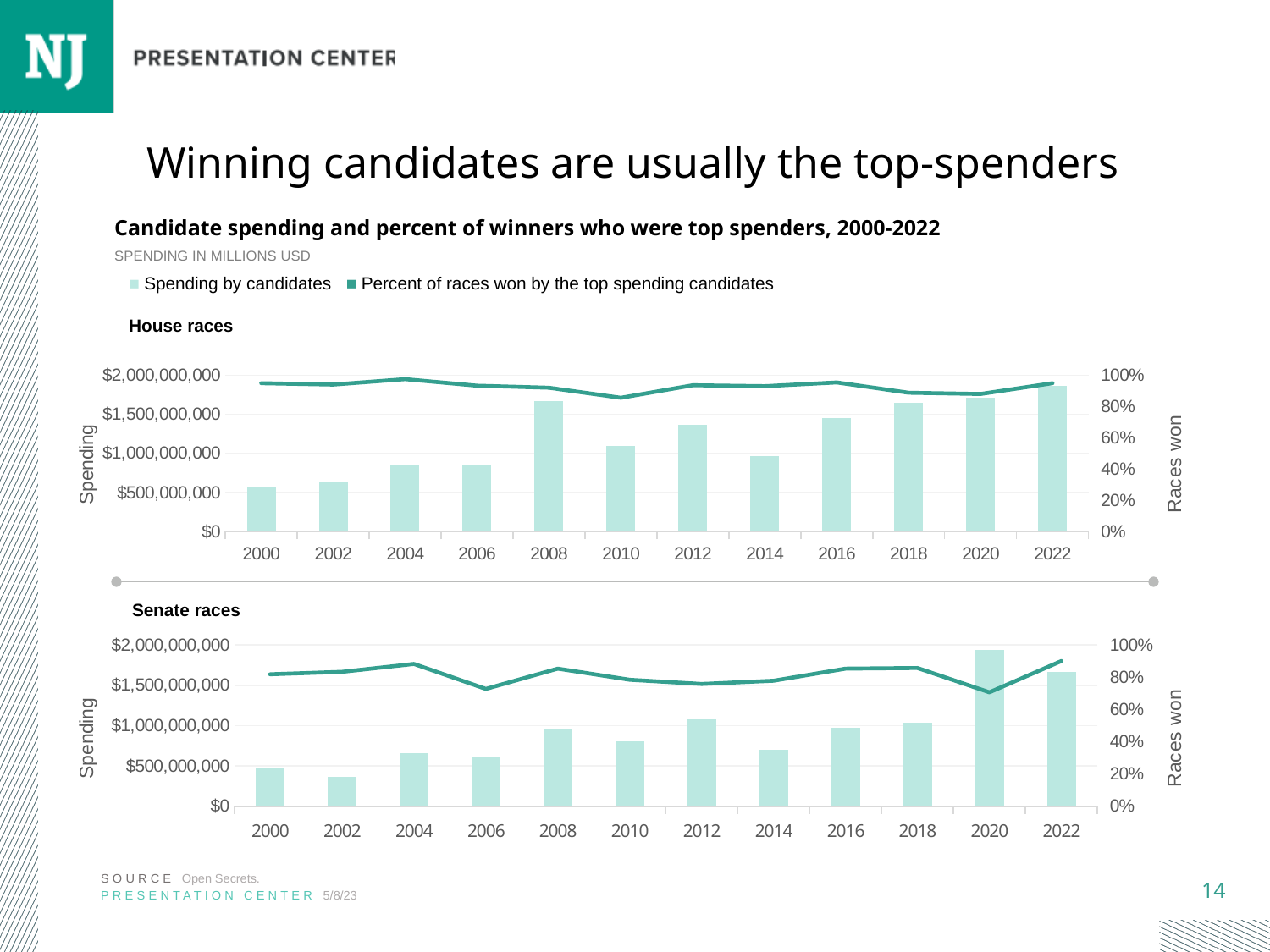
In the House races chart, which year has higher spending by candidates, 2014 or 2016? 2016 In the Senate races chart, is the percent of races won by the top spending candidates in 2020 greater or less than 80%? less How many series does the legend list? 2 In the House races chart, which year has the highest spending by candidates? 2022 In the Senate races chart, is spending by candidates in 2002 greater or less than $500,000,000? less What kind of chart is the House races chart? A combined bar and line chart What unit is spending shown in, according to the subtitle? Millions USD In the Senate races chart, which year has the lowest spending by candidates? 2002 In the House races chart, is spending by candidates in 2008 greater or less than $1,500,000,000? greater In the Senate races chart, which year has higher spending by candidates, 2020 or 2022? 2020 How many years are plotted on the x axis of the Senate races chart? 12 In the Senate races chart, which year has the highest spending by candidates? 2020